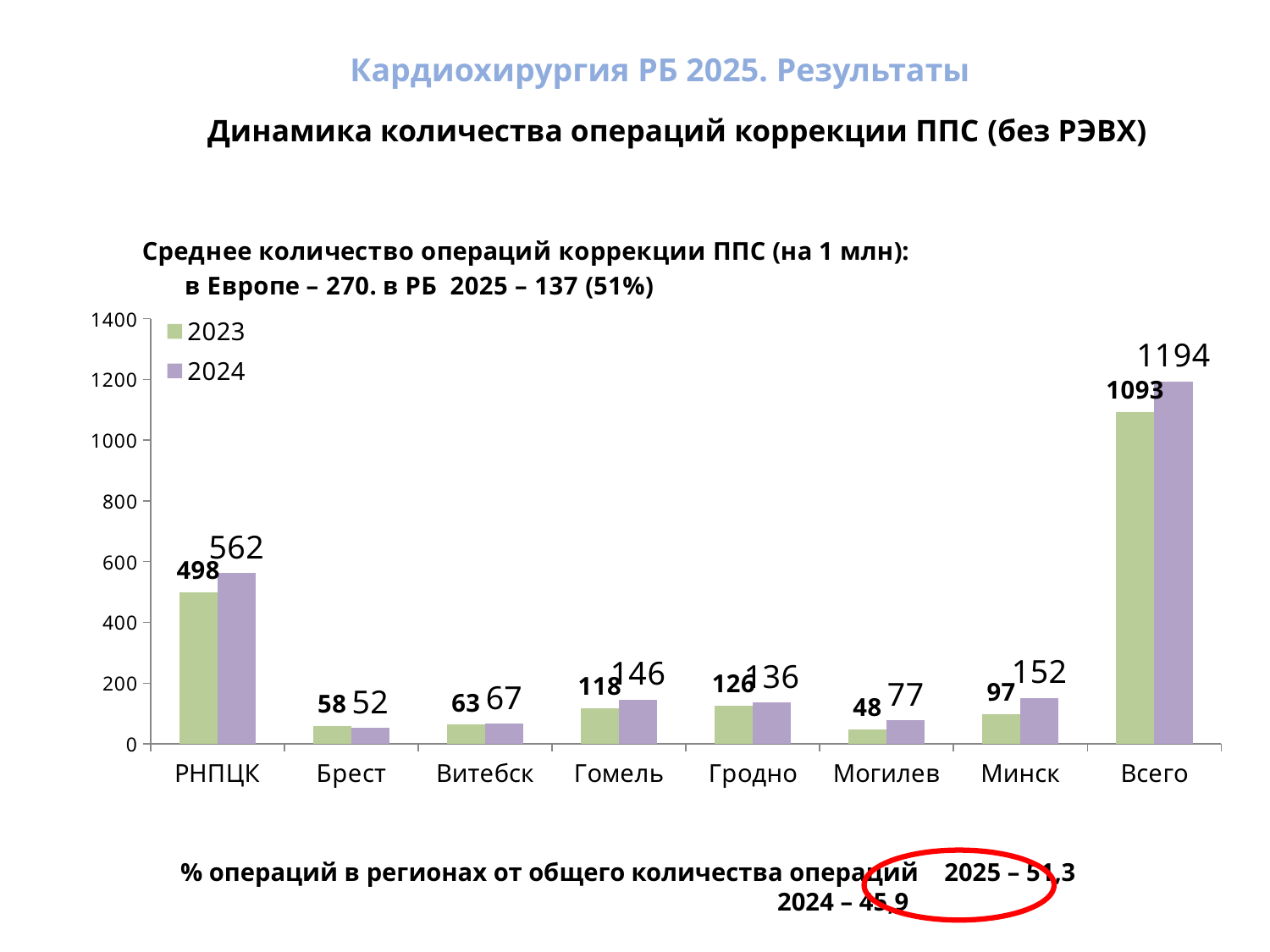
What is the difference between the 2024 and 2023 values for Всего? 101 What is the 2024 value for Минск? 152 Is the 2024 value for Гомель greater or less than 200? less How many series does the legend list? 2 What is the 2024 value for РНПЦК? 562 Excluding Всего, which region has the lowest 2023 value? Могилев Excluding Всего, which region has the highest 2024 value? РНПЦК What is the 2023 value for Могилев? 48 What is the 2023 value for Всего? 1093 What type of chart is shown on the slide? bar chart How many categories are shown on the x axis? 8 Which is larger for Брест: the 2023 value or the 2024 value? 2023